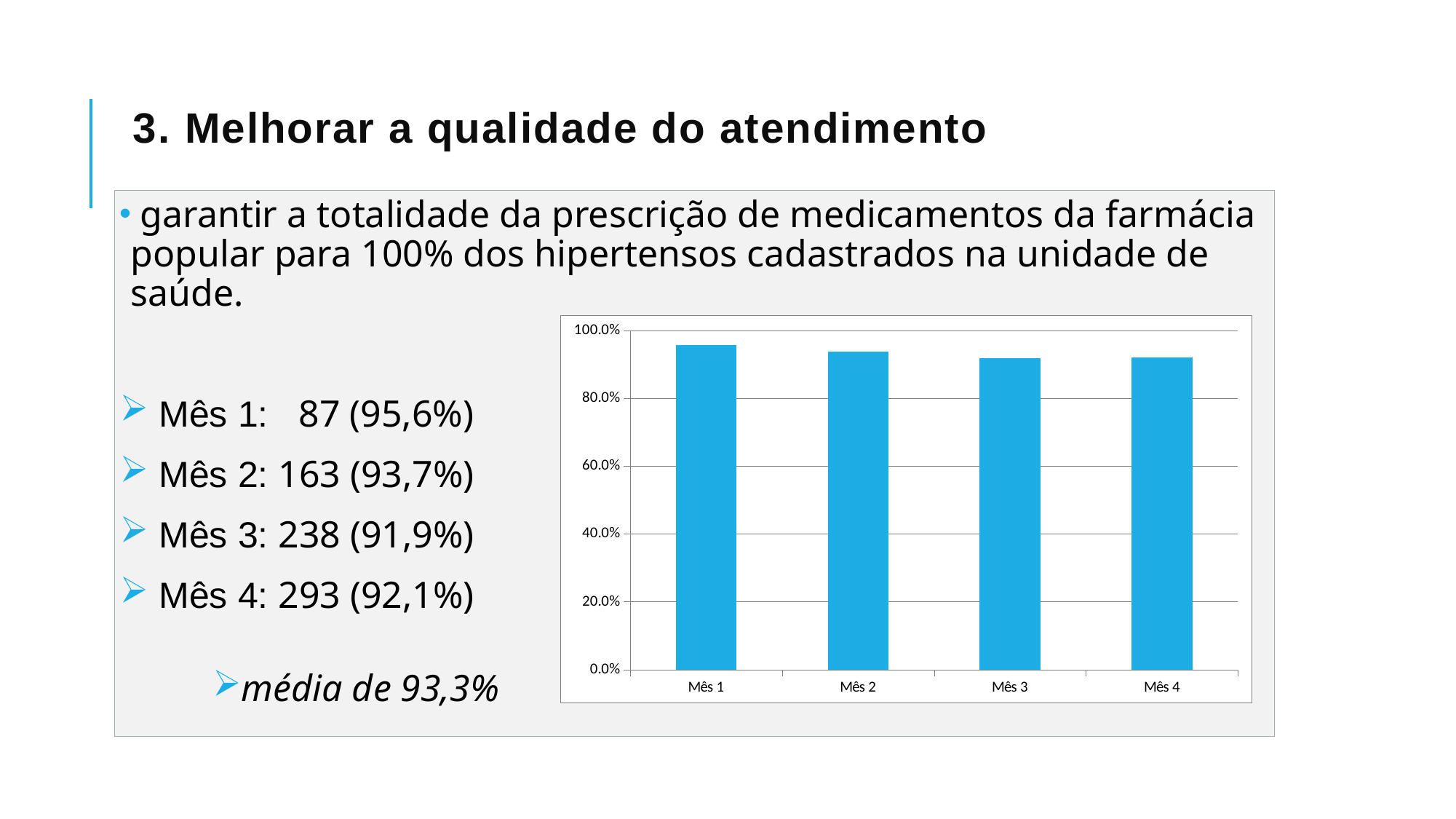
What kind of chart is shown on the slide? bar chart Is the value for Mês 2 greater or less than 80.0%? greater Which is larger on the chart, the value for Mês 2 or the value for Mês 4? Mês 2 Is the value for Mês 3 greater or less than 100.0%? less Is the value for Mês 1 greater or less than 80.0%? greater What is the highest tick value shown on the y axis? 100.0% What is the label of the first category on the x axis? Mês 1 Which is larger on the chart, the value for Mês 1 or the value for Mês 3? Mês 1 Which month has the highest bar on the chart? Mês 1 Do the bar values generally rise or fall from Mês 1 to Mês 3? fall How many categories (months) are plotted on the chart? 4